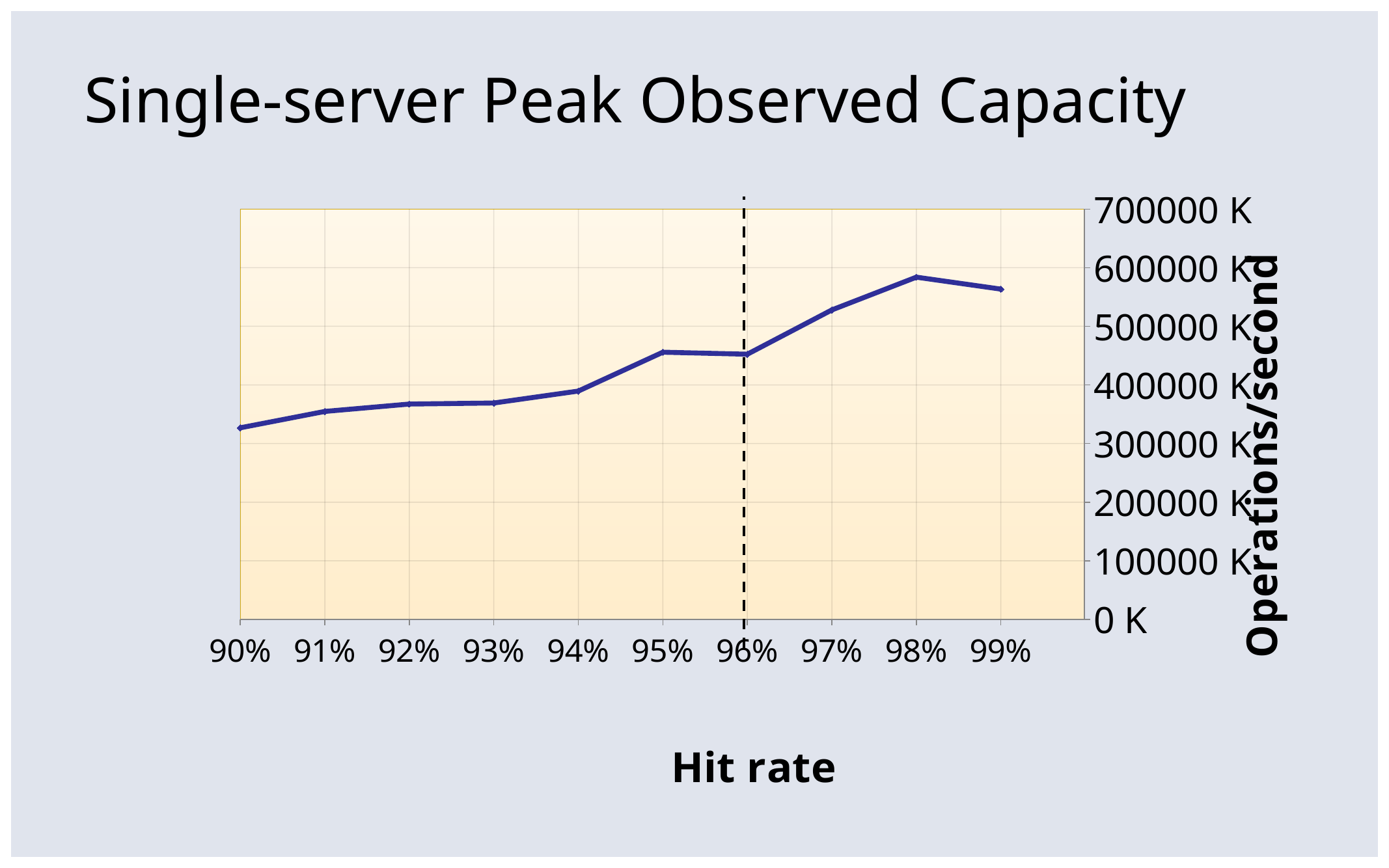
Is the value at 95% hit rate greater or less than 400000 K? greater At which hit rate is the operations/second value highest? 98% Is the value at 90% hit rate greater or less than 400000 K? less What is the title of the chart? Single-server Peak Observed Capacity At which hit rate is the operations/second value lowest? 90% Which has the larger value, 99% hit rate or 98% hit rate? 98% Which has the larger value, 97% hit rate or 94% hit rate? 97% Is the value at 98% hit rate greater or less than 500000 K? greater How many hit rate points are plotted on the x axis? 10 What is the label of the x axis? Hit rate Do the values generally rise or fall as the hit rate increases from 90% to 98%? rise What kind of chart is shown on the slide? line chart